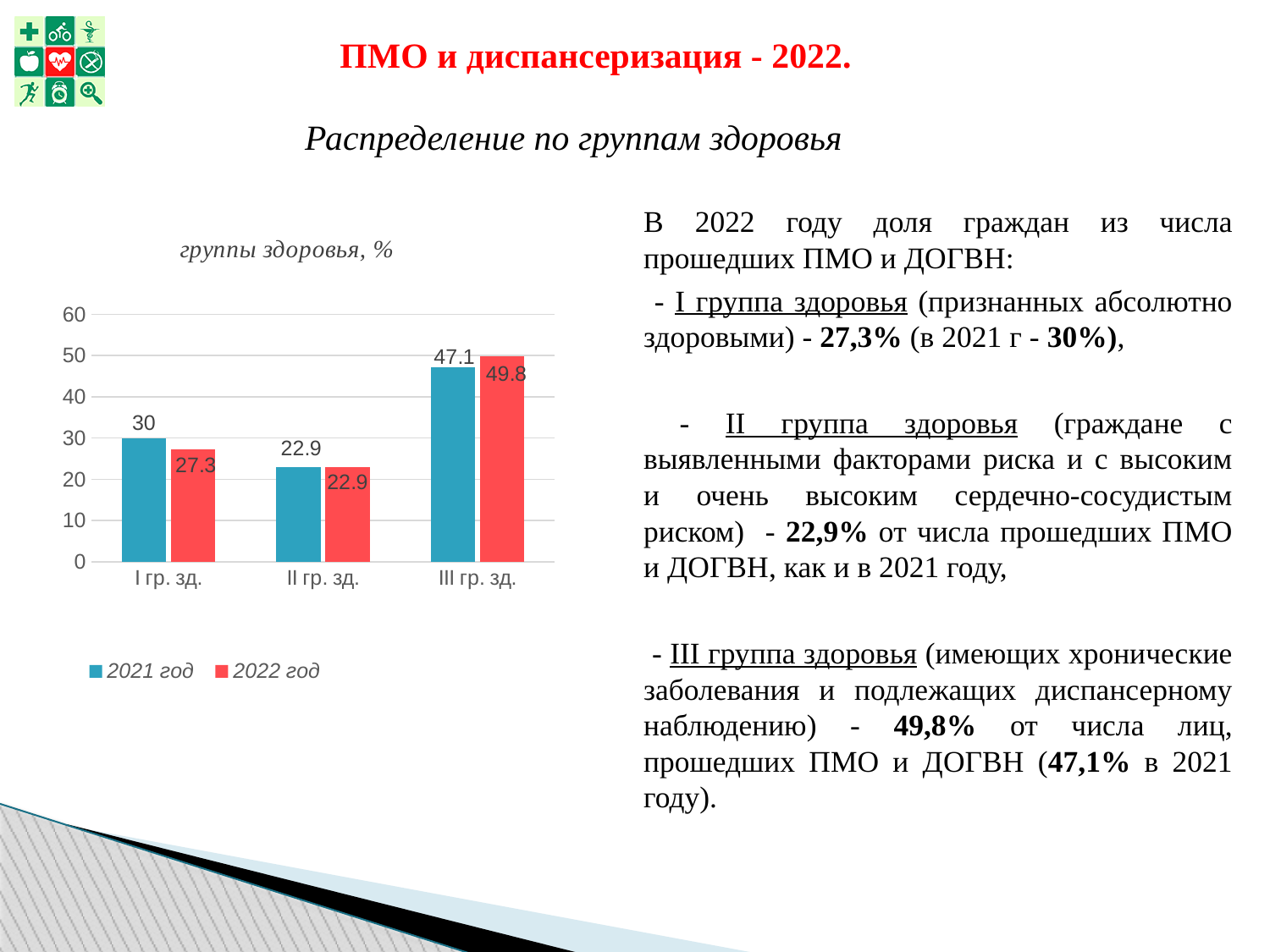
What is the difference between the 2022 год and 2021 год values for III гр. зд.? 2.7 What is the difference between the 2021 год and 2022 год values for I гр. зд.? 2.7 Which category has the highest value in the 2022 год series? III гр. зд. Which category has the lowest value in the 2021 год series? II гр. зд. Which is larger for I гр. зд.: the 2021 год value or the 2022 год value? 2021 год What is the value for II гр. зд. in the 2021 год series? 22.9 How many series does the legend list? 2 What kind of chart is shown on the slide? bar chart What is the value for III гр. зд. in the 2022 год series? 49.8 What is the value for I гр. зд. in the 2021 год series? 30 How many categories are shown on the x axis? 3 Is the 2022 год value for III гр. зд. greater or less than 40? greater